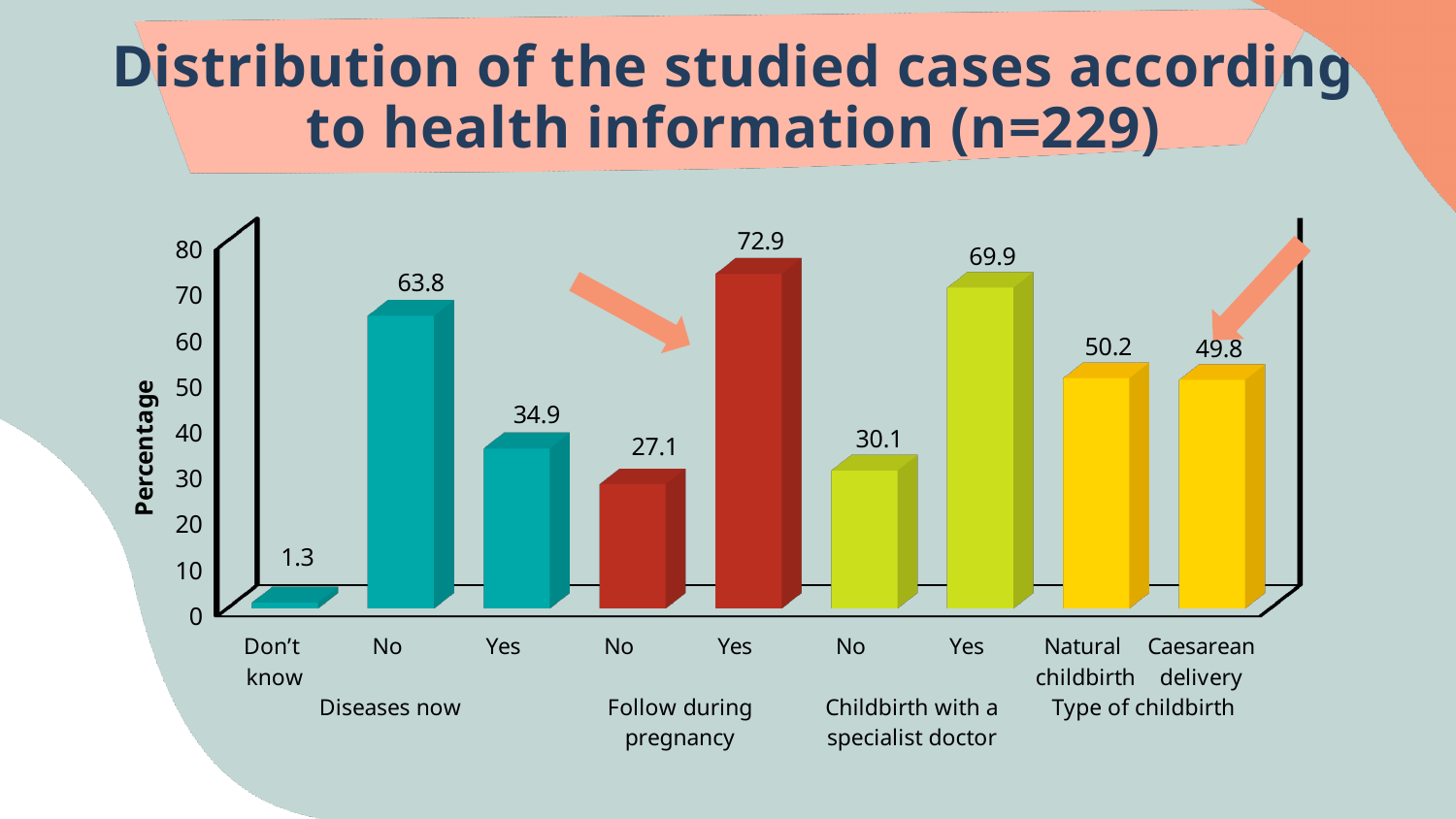
How many bars are plotted on the chart? 9 What percentage of cases answered 'No' for Diseases now? 63.8 Which bar has the highest value on the chart? Yes (Follow during pregnancy) What is the difference between 'Yes' and 'No' for Childbirth with a specialist doctor? 39.8 Which is larger: 'Yes' for Diseases now or 'No' for Follow during pregnancy? Yes for Diseases now What is the value for 'Don't know' under Diseases now? 1.3 Is the value for 'No' under Childbirth with a specialist doctor greater or less than 40? less What percentage of cases had a Caesarean delivery? 49.8 What type of chart is shown on the slide? Bar chart What is the label of the vertical axis? Percentage Which bar has the lowest value on the chart? Don't know (Diseases now) What is the value for 'Yes' under Follow during pregnancy? 72.9